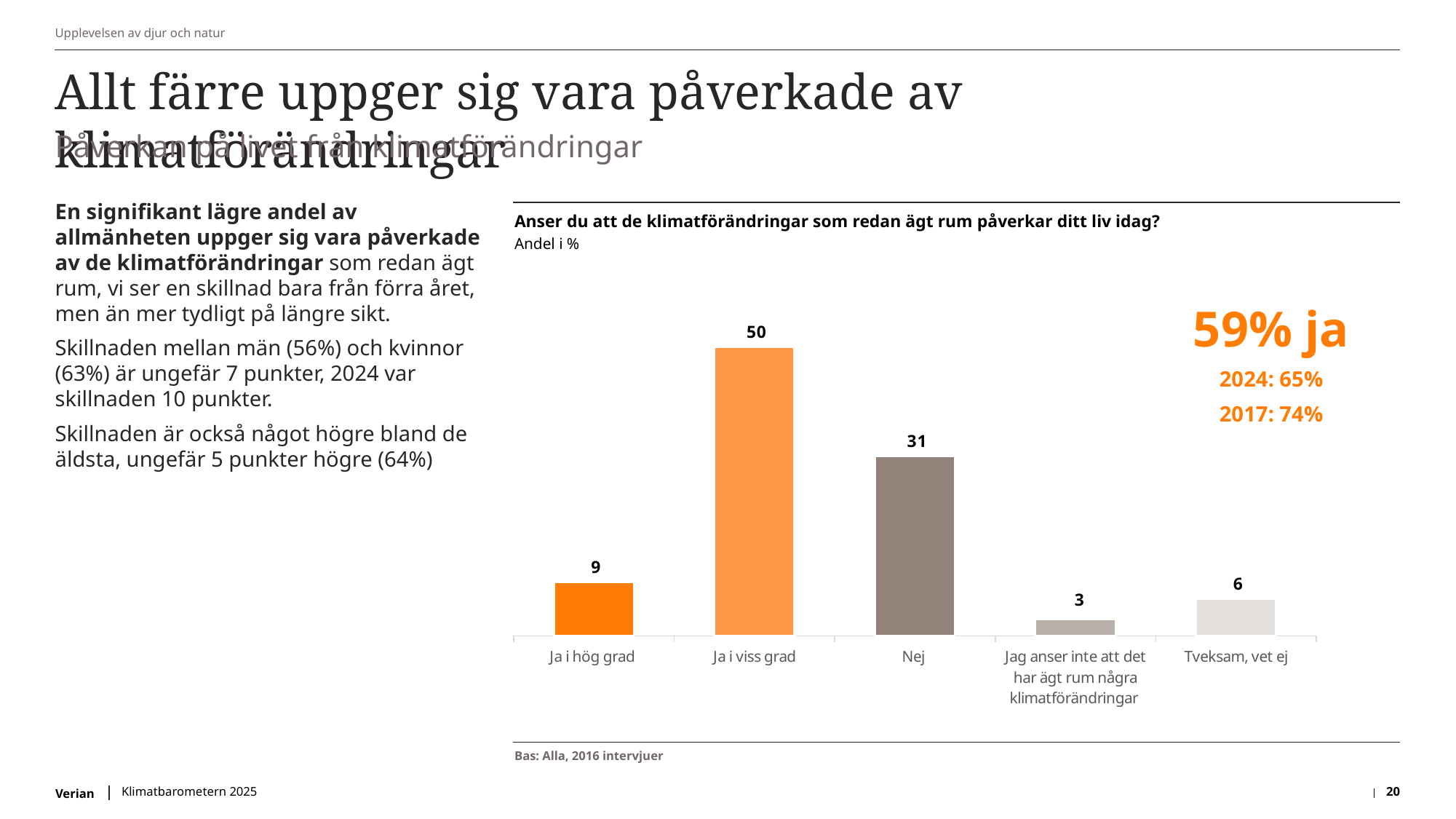
What is the value for "Tveksam, vet ej"? 6 Which category has the lowest value? Jag anser inte att det har ägt rum några klimatförändringar What is the value for "Ja i viss grad"? 50 How many categories are shown on the x axis? 5 What is the value for "Nej"? 31 What is the total of the values for "Ja i hög grad" and "Ja i viss grad"? 59 Which is larger, the value for "Ja i hög grad" or the value for "Tveksam, vet ej"? Ja i hög grad What is the question shown as the chart's title? Anser du att de klimatförändringar som redan ägt rum påverkar ditt liv idag? What is the value for "Ja i hög grad"? 9 What kind of chart is shown? Bar chart Which category has the highest value? Ja i viss grad What is the difference between the values for "Ja i viss grad" and "Nej"? 19